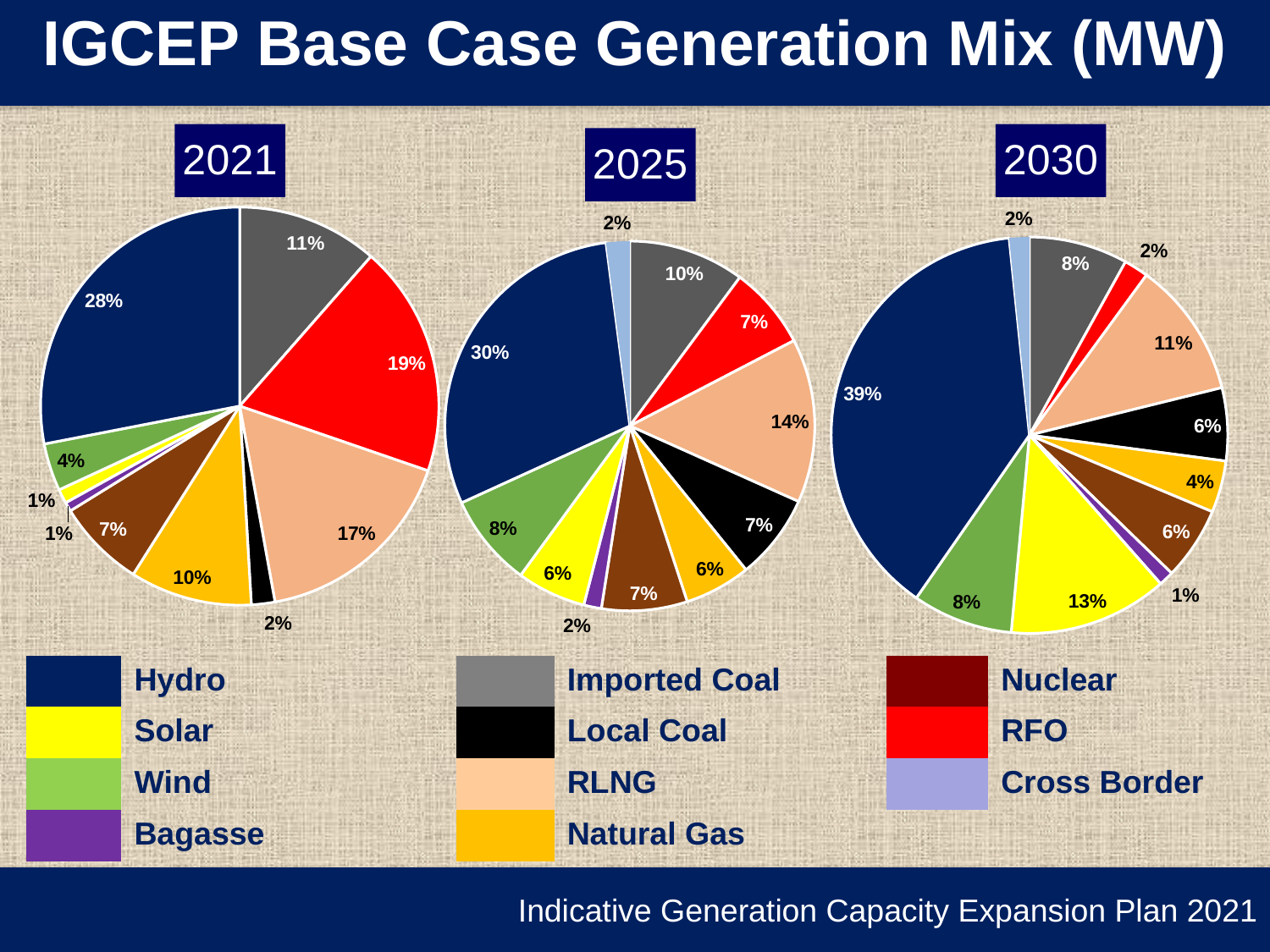
How many generation sources does the legend list? 11 What type of chart is used to show the generation mix for each year? Pie chart In the 2030 pie chart, what share is Solar? 13% How does the Hydro share change across the 2021, 2025 and 2030 pie charts? It rises In the 2021 pie chart, what share of the generation mix is Hydro? 28% In the 2021 pie chart, what share is Natural Gas? 10% How many pie charts are shown on the slide? 3 In the 2030 pie chart, which source has the largest slice? Hydro In the 2030 pie chart, what share of the generation mix is Hydro? 39% In the 2025 pie chart, what share is RLNG? 14% In the 2021 pie chart, which is larger, the RFO slice or the RLNG slice? RFO By how many percentage points does the RFO share in 2021 exceed the RFO share in 2030? 17 percentage points